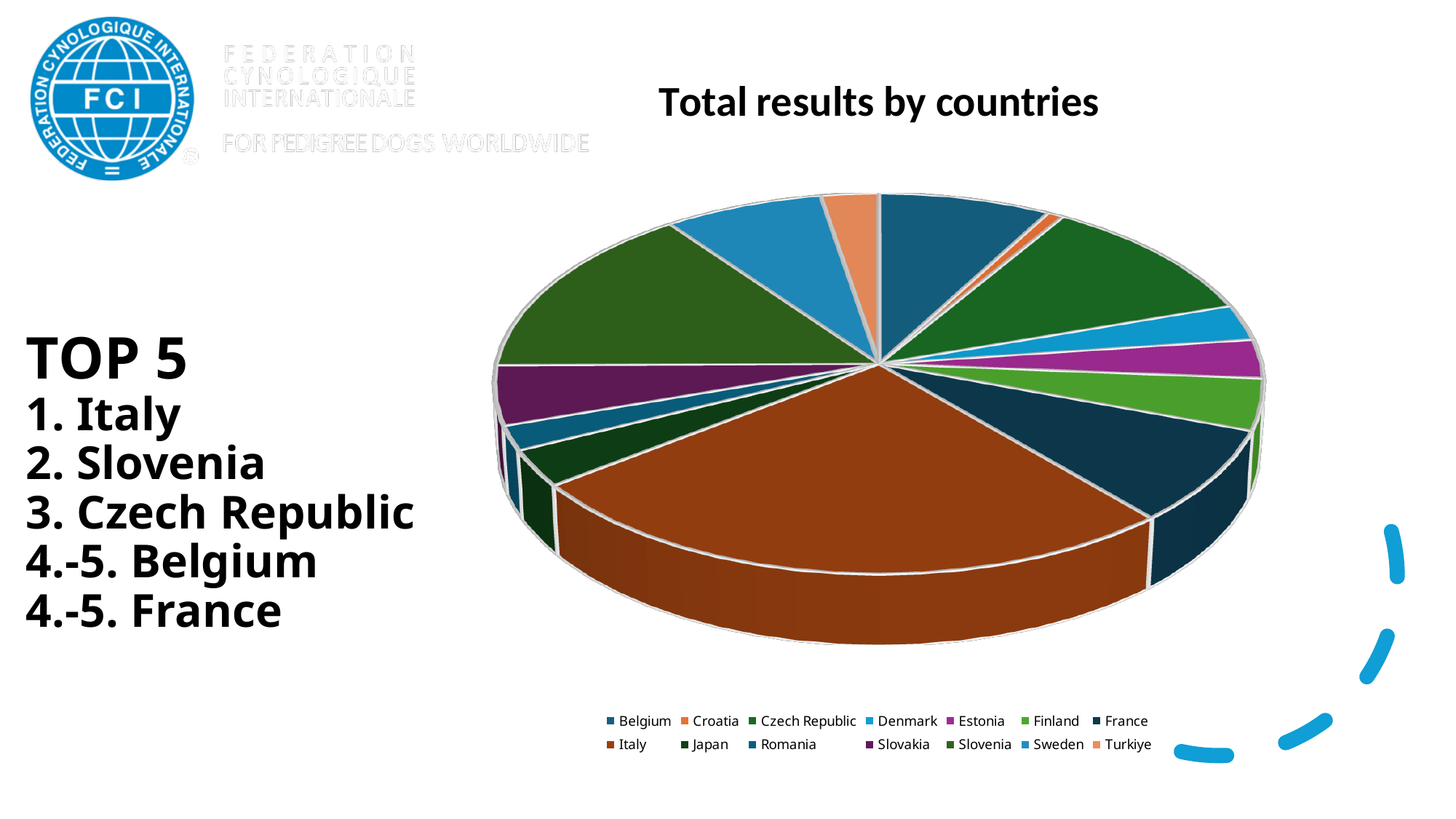
What kind of chart is shown on the slide? Pie chart Which slice is larger, Sweden or Turkiye? Sweden How many countries are listed in the chart's legend? 14 Which slice is larger, Czech Republic or Estonia? Czech Republic Which country is listed first in the chart's legend? Belgium Which country has the largest slice of the pie? Italy Which country has the smallest slice of the pie? Croatia Which slice is larger, Slovakia or Croatia? Slovakia What is the title of the chart? Total results by countries